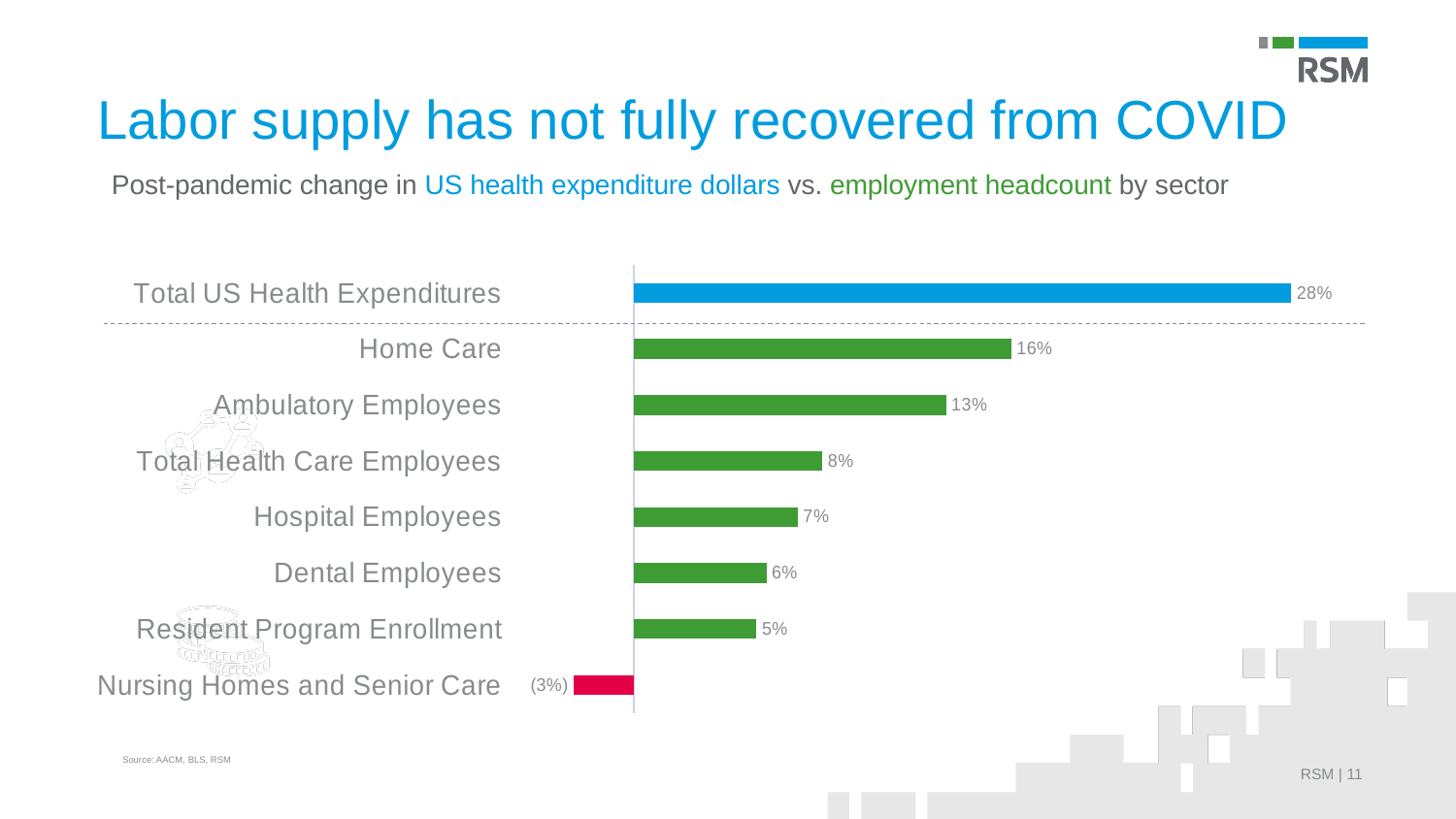
Which category's bar is shown in red? Nursing Homes and Senior Care What is the difference between the values for Home Care and Ambulatory Employees? 3% What is the difference between the values for Total US Health Expenditures and Total Health Care Employees? 20% Which is larger, the value for Dental Employees or the value for Resident Program Enrollment? Dental Employees What is the value shown for Nursing Homes and Senior Care? (3%) Which category has the lowest value on the chart? Nursing Homes and Senior Care Which category has the highest value on the chart? Total US Health Expenditures What is the value shown for Total US Health Expenditures? 28% What kind of chart is shown on the slide? Bar chart What is the value shown for Hospital Employees? 7% What is the value shown for Home Care? 16% How many categories are shown on the chart? 8